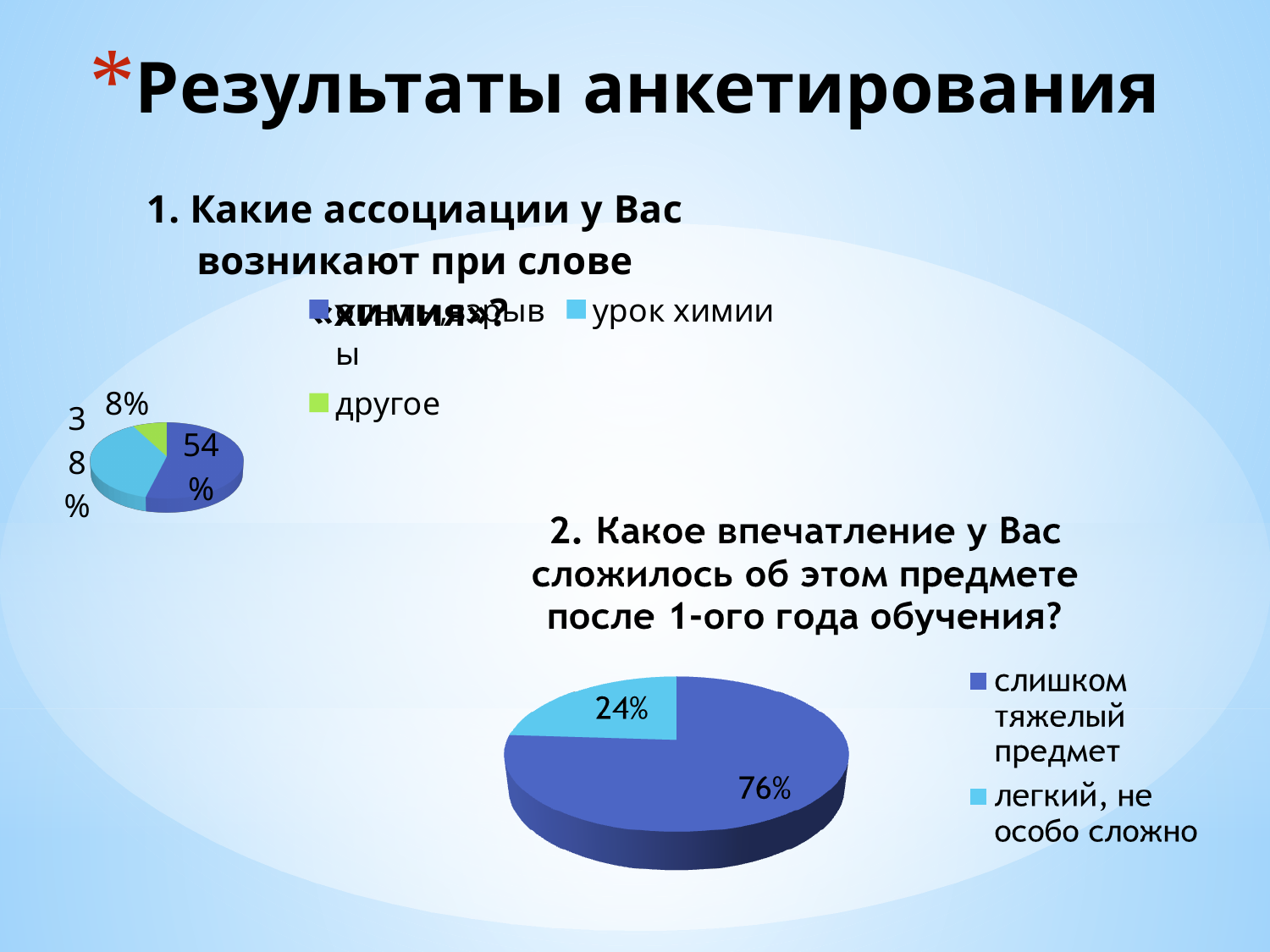
How many slices does the pie chart for question 2 have? 2 In the pie chart for question 1 (associations with the word "химия"), what percentage is shown for "другое"? 8% In the pie chart for question 2, which category has the largest slice? слишком тяжелый предмет In the pie chart for question 1, what is the difference between the "урок химии" share and the "другое" share? 30% In the pie chart for question 1, which is larger: "урок химии" or "другое"? урок химии In the pie chart for question 1 (associations with the word "химия"), what percentage is shown for "урок химии"? 38% How many slices does the pie chart for question 1 have? 3 In the pie chart for question 2 (impression after the first year), what percentage is shown for "слишком тяжелый предмет"? 76% What type of chart is used for question 2 on the slide? Pie chart In the pie chart for question 1, which category has the smallest slice? другое In the pie chart for question 2, what is the difference between the "слишком тяжелый предмет" share and the "легкий, не особо сложно" share? 52% In the pie chart for question 2 (impression after the first year), what percentage is shown for "легкий, не особо сложно"? 24%